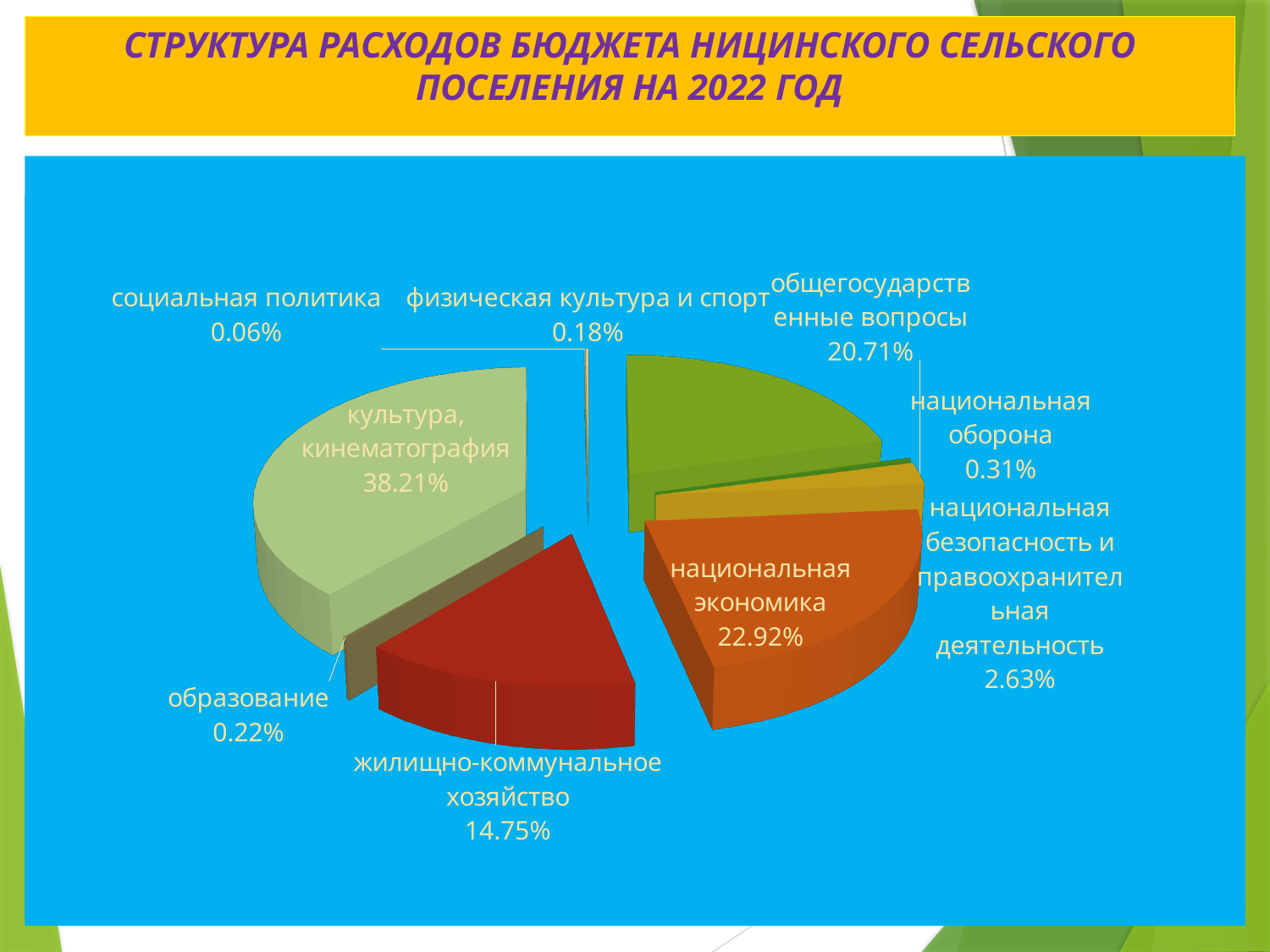
What is the value shown for жилищно-коммунальное хозяйство? 14.75% What share of the budget expenditure goes to культура, кинематография? 38.21% Which is larger: the share for жилищно-коммунальное хозяйство or the share for общегосударственные вопросы? общегосударственные вопросы What is the value shown for национальная экономика? 22.92% How many categories are shown in the pie chart? 9 What is the title of the slide containing the chart? СТРУКТУРА РАСХОДОВ БЮДЖЕТА НИЦИНСКОГО СЕЛЬСКОГО ПОСЕЛЕНИЯ НА 2022 ГОД What is the difference between the shares of национальная экономика and общегосударственные вопросы? 2.21% What kind of chart is shown on the slide? pie chart What is the value shown for национальная безопасность и правоохранительная деятельность? 2.63% Which category has the smallest share of the pie? социальная политика Which category has the largest share of the pie? культура, кинематография What is the value shown for общегосударственные вопросы? 20.71%